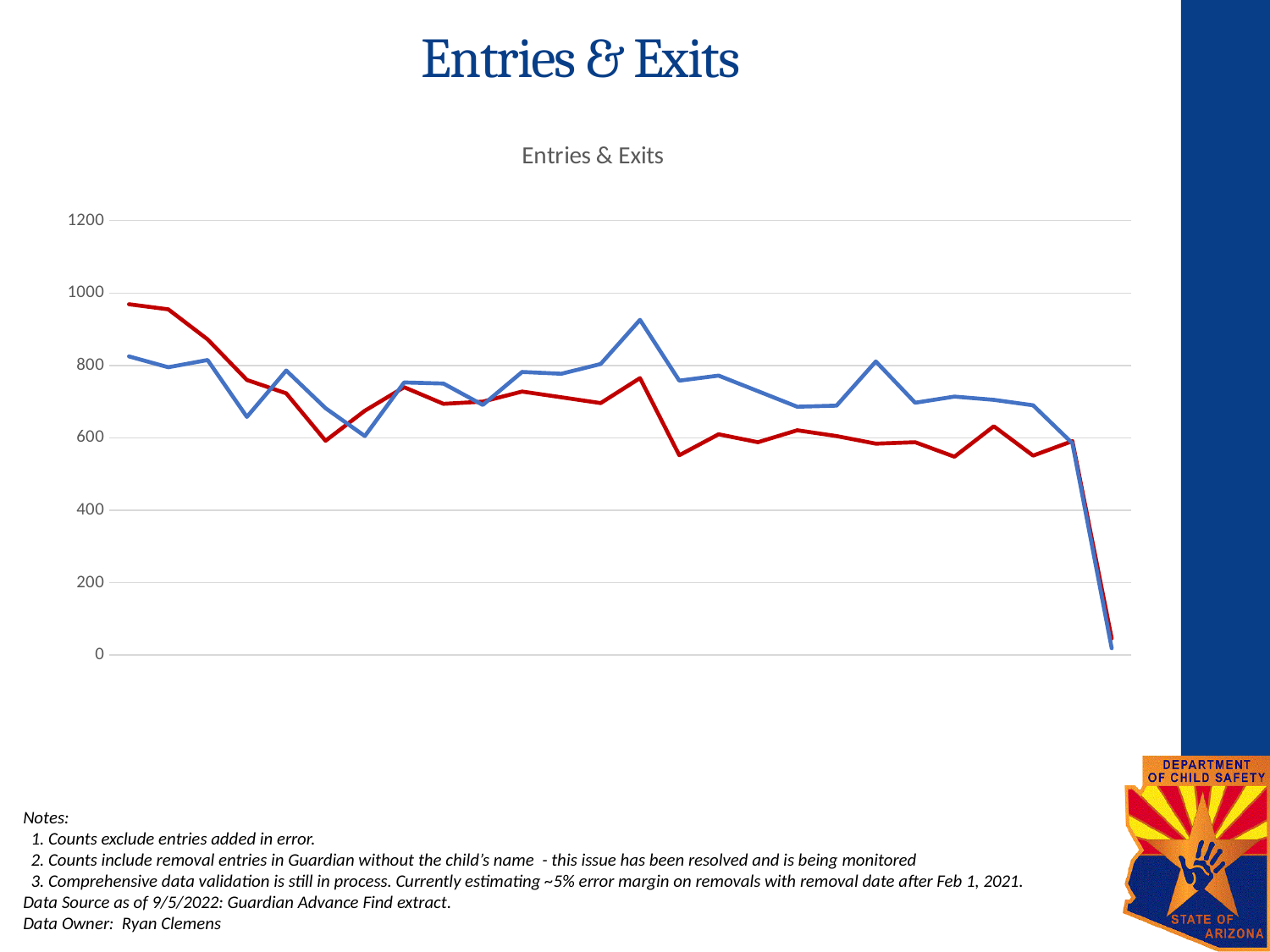
What is the title of the chart? Entries & Exits Is the value of the red line at its leftmost point greater or less than 800? greater Do the values of the red line generally rise or fall from left to right? fall Is the value of the blue line at its rightmost point greater or less than 200? less Is the highest point of the blue line greater or less than 800? greater At the leftmost point of the chart, which line is higher, the red line or the blue line? the red line How many lines are plotted on the chart? 2 What colours are the two lines on the chart? red and blue Do the values of the blue line generally rise or fall from left to right? fall What is the highest value shown on the vertical axis? 1200 What kind of chart is shown on the slide? line chart